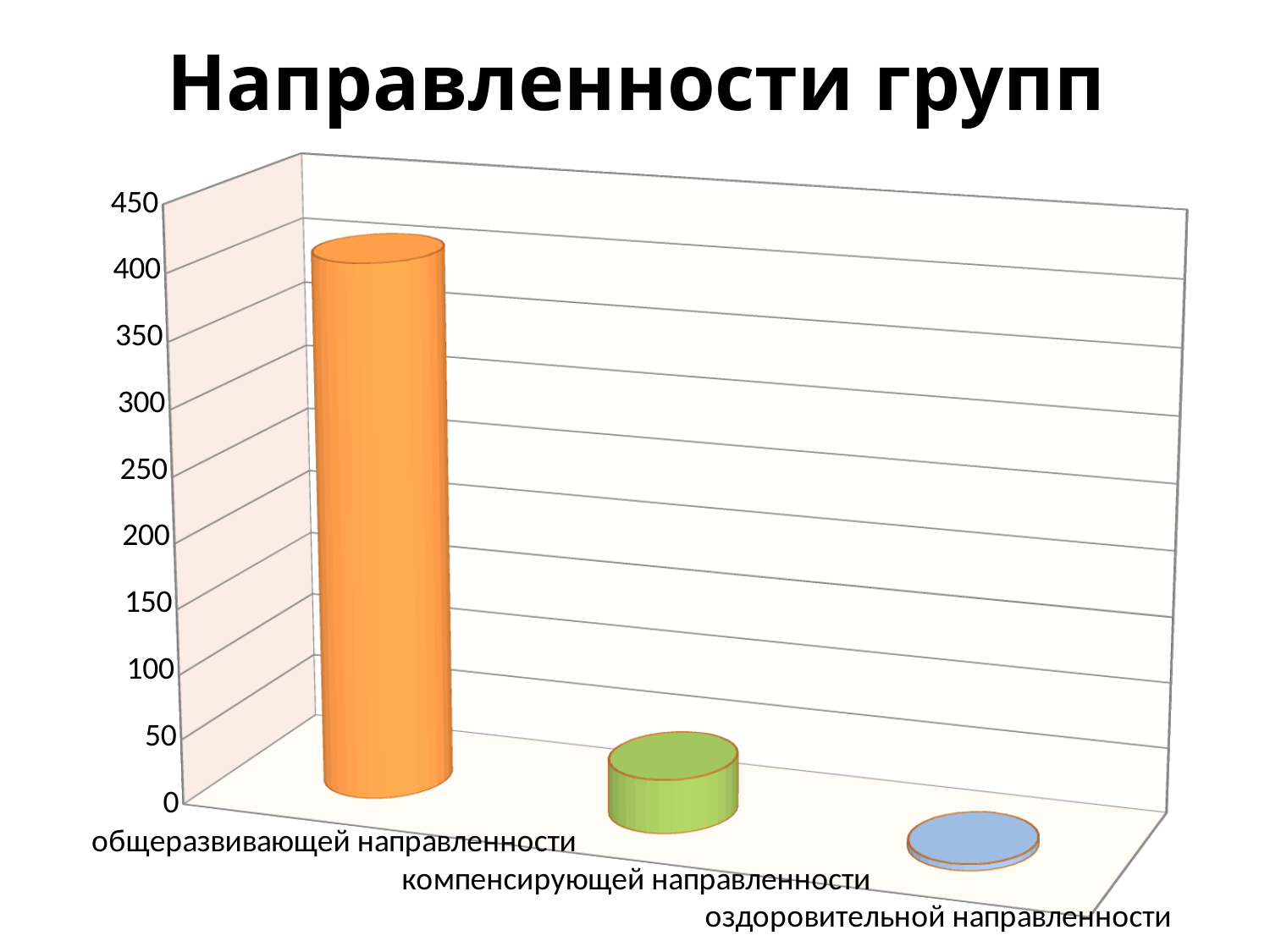
How many categories are plotted in the chart? 3 Which is larger: the value for компенсирующей направленности or the value for оздоровительной направленности? компенсирующей направленности Which is larger: the value for общеразвивающей направленности or the value for компенсирующей направленности? общеразвивающей направленности Is the value for компенсирующей направленности greater or less than 100? less Do the values rise or fall from left to right along the x axis? fall What is the title of the chart? Направленности групп Is the value for оздоровительной направленности greater or less than 50? less What kind of chart is shown on the slide? bar chart Is the value for общеразвивающей направленности greater or less than 350? greater What colour is the bar for общеразвивающей направленности? orange Which category has the lowest value? оздоровительной направленности Which category has the highest value? общеразвивающей направленности